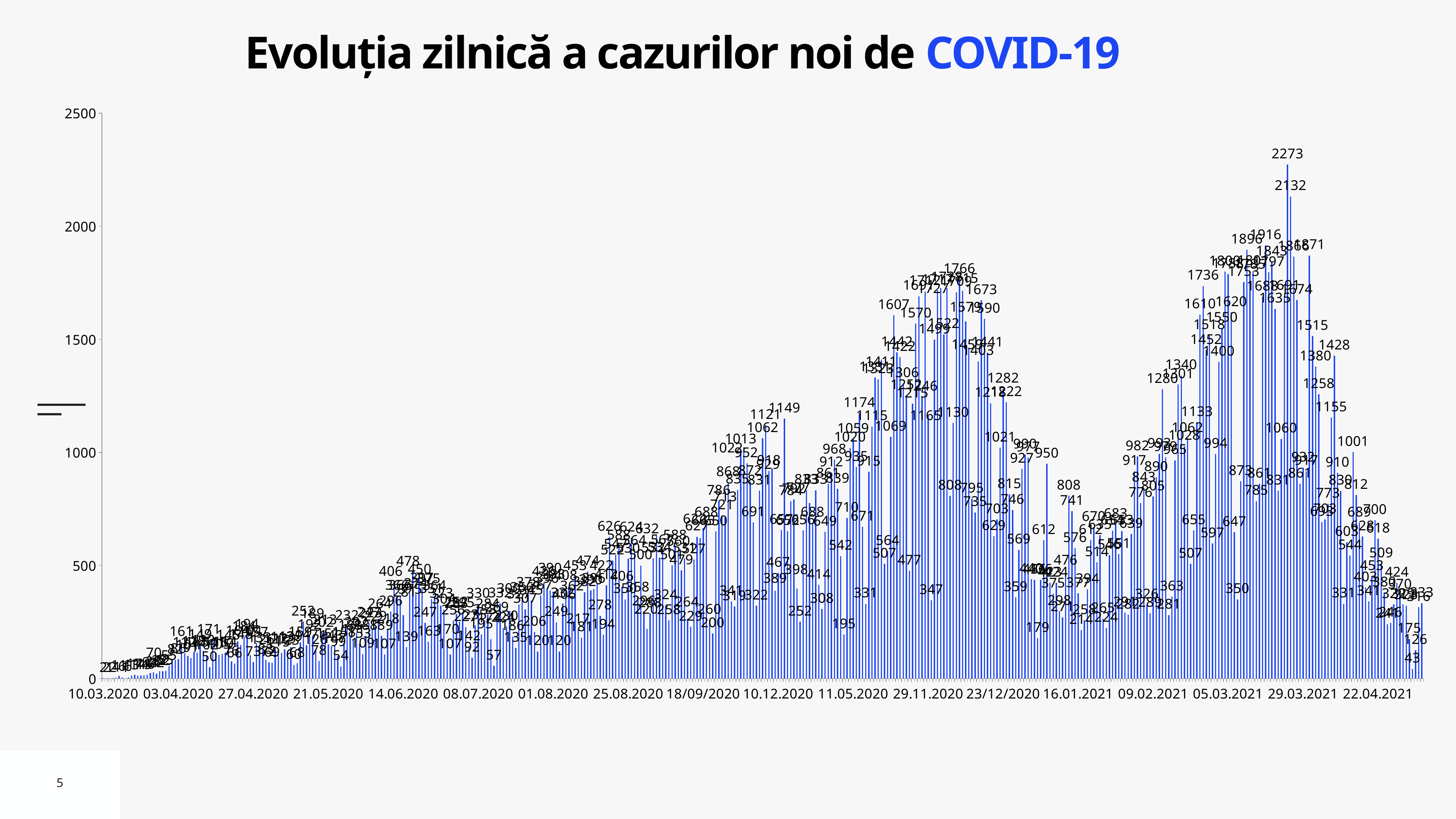
What is the title of the chart? Evoluția zilnică a cazurilor noi de COVID-19 Do the values generally rise or fall between 10.03.2020 and 14.06.2020? rise What is the first date label on the horizontal axis? 10.03.2020 Which is larger, the peak value 2273 or the value 1766? 2273 Is the highest bar on the chart greater or less than 2000? greater What kind of chart is shown on the slide? bar chart What is the second highest data label shown on the chart? 2132 What is the difference between the two highest labelled values, 2273 and 2132? 141 What is the last date label on the horizontal axis? 22.04.2021 What is the highest daily value shown on the chart? 2273 What is the highest tick value on the vertical axis? 2500